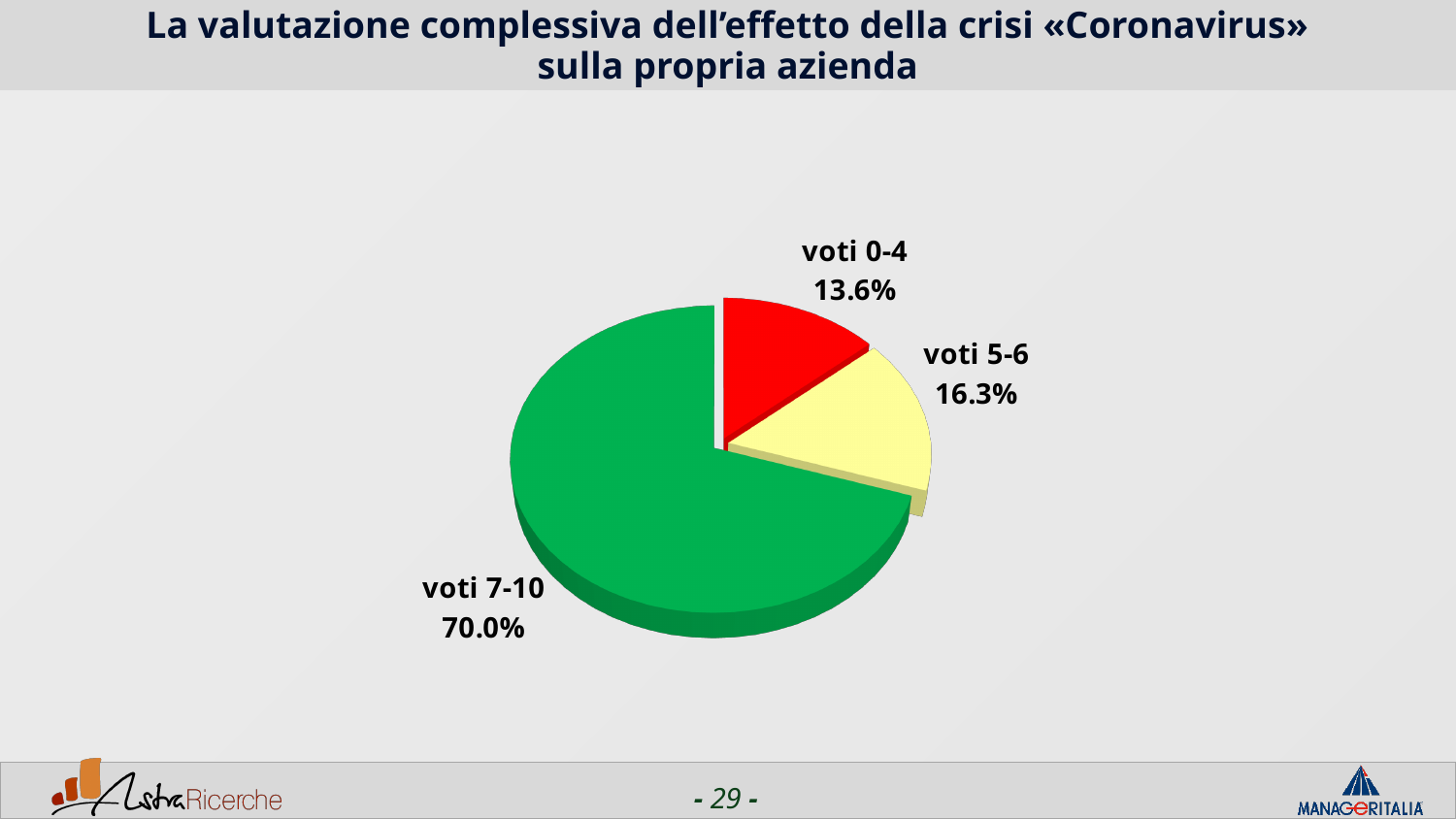
What is the value shown for "voti 5-6"? 16.3% What share of the pie does the slice "voti 7-10" represent? 70.0% Which category has the largest slice of the pie? voti 7-10 Which category has the smallest slice of the pie? voti 0-4 What colour is the slice for "voti 7-10"? green How many slices does the pie chart have? 3 What kind of chart is shown on the slide? pie chart Which is larger, the value for "voti 5-6" or the value for "voti 0-4"? voti 5-6 What is the value shown for "voti 0-4"? 13.6% What is the difference between the values for "voti 7-10" and "voti 5-6"? 53.7% What colour is the slice for "voti 0-4"? red What is the difference between the values for "voti 5-6" and "voti 0-4"? 2.7%